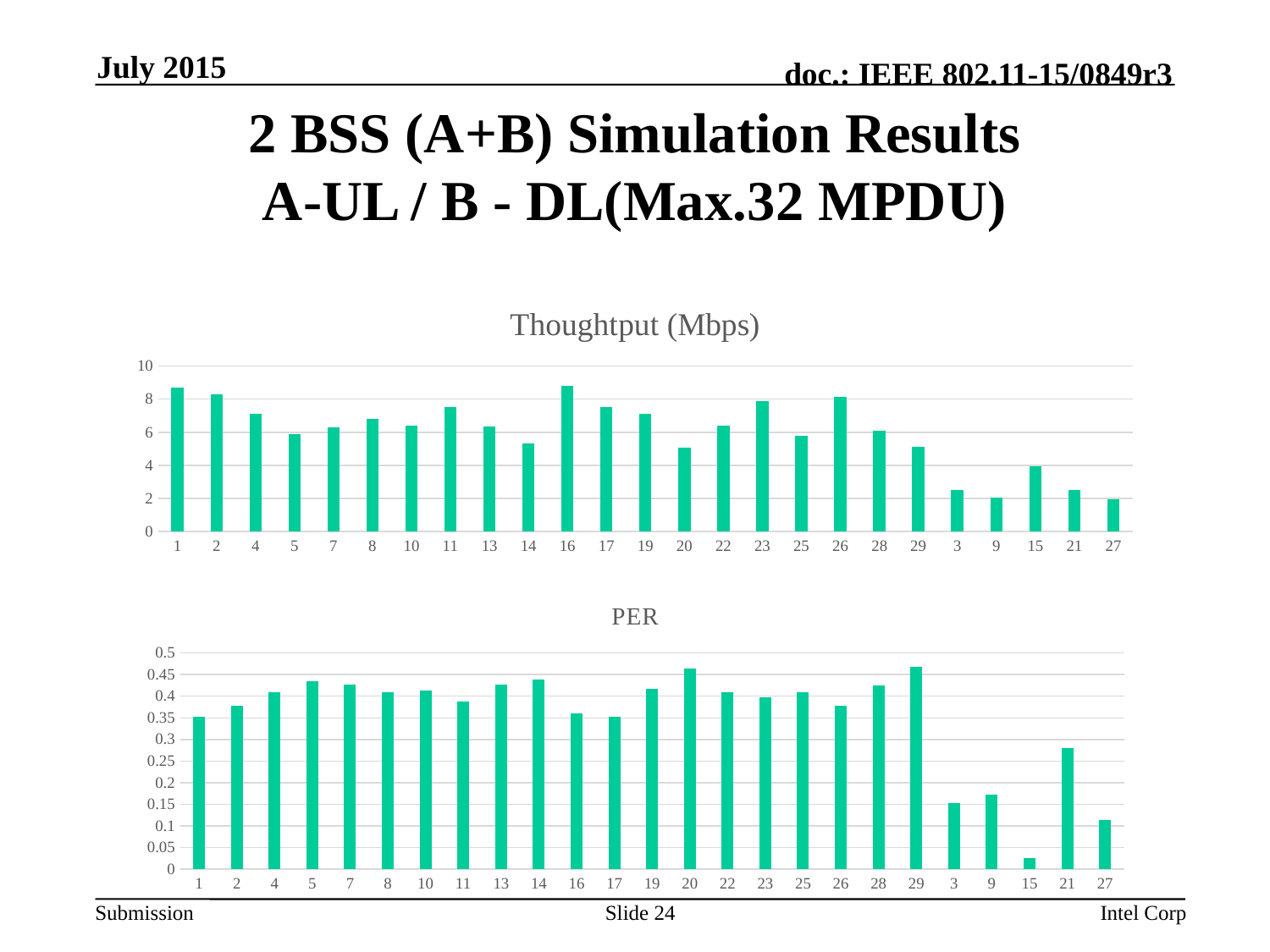
In the Thoughtput (Mbps) chart, is the value for category 3 greater or less than 4? less What kind of chart is the Thoughtput (Mbps) chart? bar chart In the Thoughtput (Mbps) chart, is the value for category 20 greater or less than 4? greater In the Thoughtput (Mbps) chart, which is larger, the value for category 1 or the value for category 27? 1 In the PER chart, which is larger, the value for category 29 or the value for category 15? 29 In the PER chart, is the value for category 15 greater or less than 0.05? less What is the title of the lower chart on the slide? PER In the PER chart, which category has the lowest value? 15 How many categories are shown on the x axis of the PER chart? 25